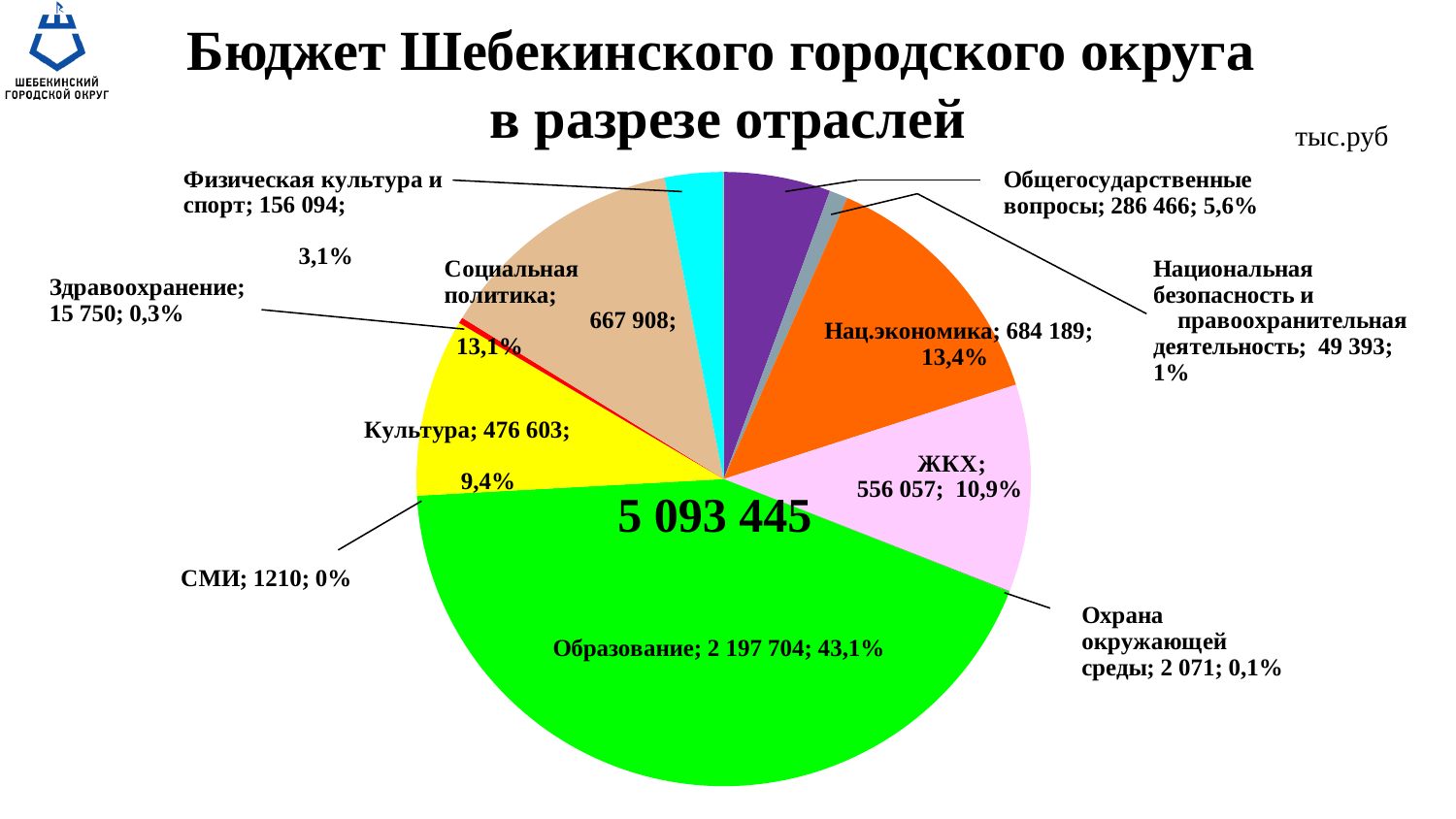
How many sectors are shown in the pie chart? 11 What share of the pie does Нац.экономика represent? 13,4% What is the total budget shown in the centre of the pie chart? 5 093 445 What share of the pie does Здравоохранение represent? 0,3% Which is larger, the value for Культура or the value for ЖКХ? ЖКХ What is the value for ЖКХ? 556 057 What type of chart is shown on the slide? pie chart What is the difference between the values for Нац.экономика and Социальная политика? 16 281 What is the value for Образование? 2 197 704 What unit is indicated for the values on the chart? тыс.руб Which sector has the largest share of the budget? Образование Which sector has the smallest value? СМИ